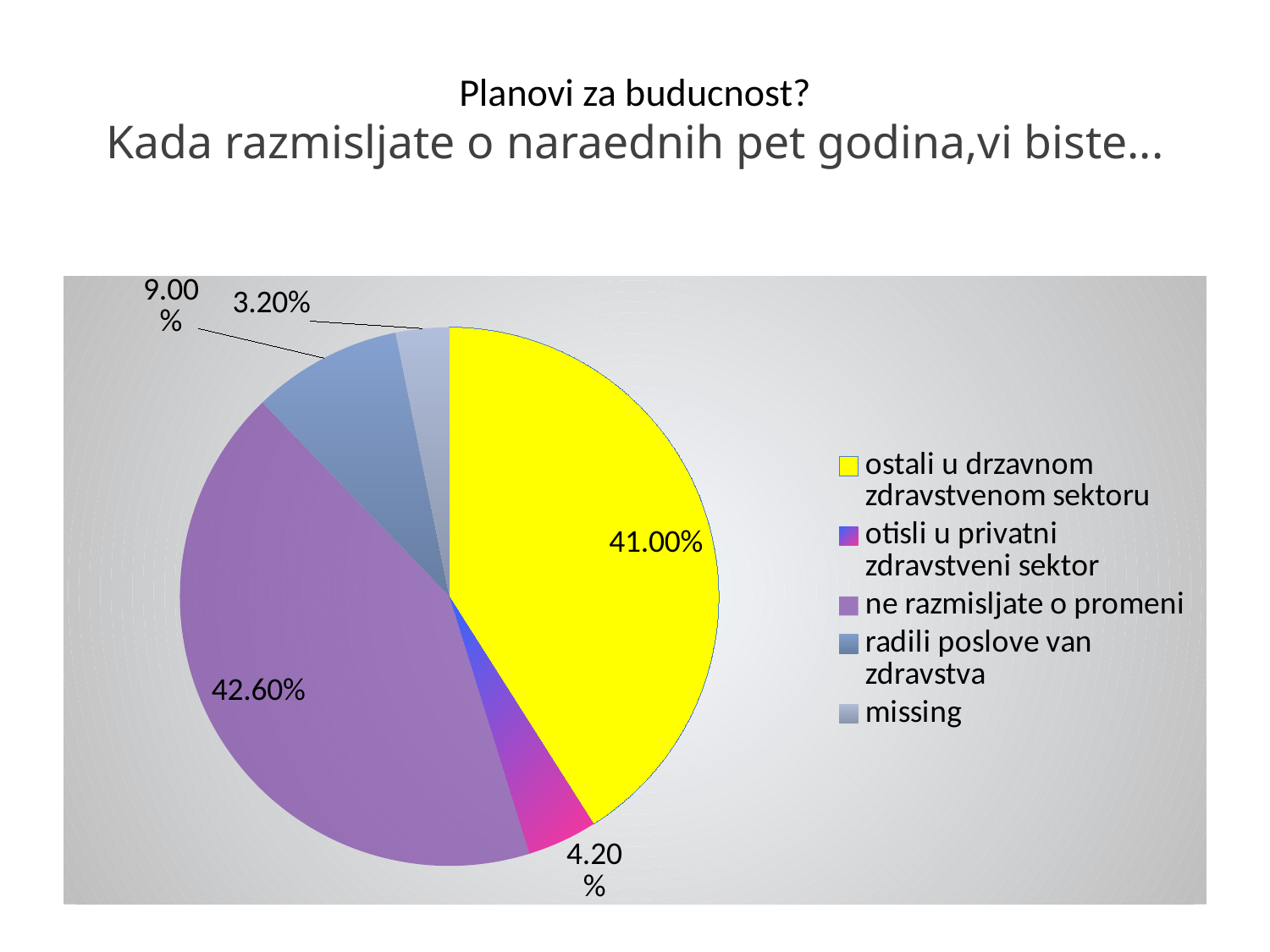
What colour is the slice for "ostali u drzavnom zdravstvenom sektoru"? yellow What share of the pie does "missing" have? 3.20% What share of the pie does "ostali u drzavnom zdravstvenom sektoru" have? 41.00% Which category has the smallest slice of the pie? missing What share of the pie does "radili poslove van zdravstva" have? 9.00% How many categories does the legend list? 5 What kind of chart is shown on the slide? pie chart What is the difference between the shares for "ne razmisljate o promeni" and "ostali u drzavnom zdravstvenom sektoru"? 1.60% What share of the pie does "ne razmisljate o promeni" have? 42.60% Which is larger: the share for "radili poslove van zdravstva" or the share for "otisli u privatni zdravstveni sektor"? radili poslove van zdravstva Which category has the largest slice of the pie? ne razmisljate o promeni What share of the pie does "otisli u privatni zdravstveni sektor" have? 4.20%